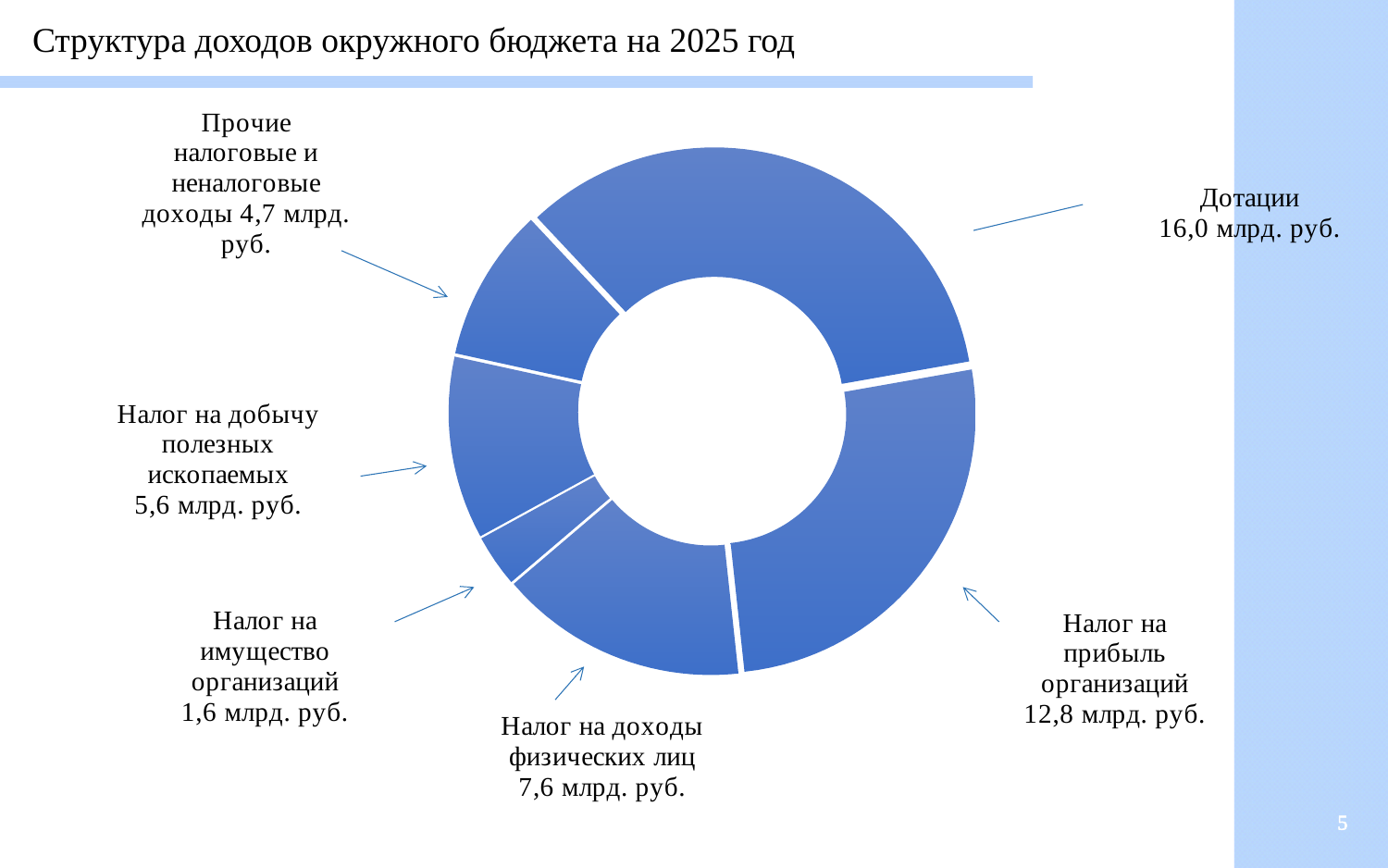
What kind of chart is shown on the slide? doughnut chart What is the value for Налог на добычу полезных ископаемых? 5,6 млрд. руб. Which category has the highest value? Дотации What is the title of the slide? Структура доходов окружного бюджета на 2025 год What is the value for Налог на имущество организаций? 1,6 млрд. руб. What is the value for Налог на доходы физических лиц? 7,6 млрд. руб. What is the value for Налог на прибыль организаций? 12,8 млрд. руб. How many categories are shown in the chart? 6 What is the difference between Дотации and Налог на прибыль организаций? 3,2 млрд. руб. What is the value for Дотации? 16,0 млрд. руб. Which is larger: Налог на добычу полезных ископаемых or Прочие налоговые и неналоговые доходы? Налог на добычу полезных ископаемых Which category has the lowest value? Налог на имущество организаций